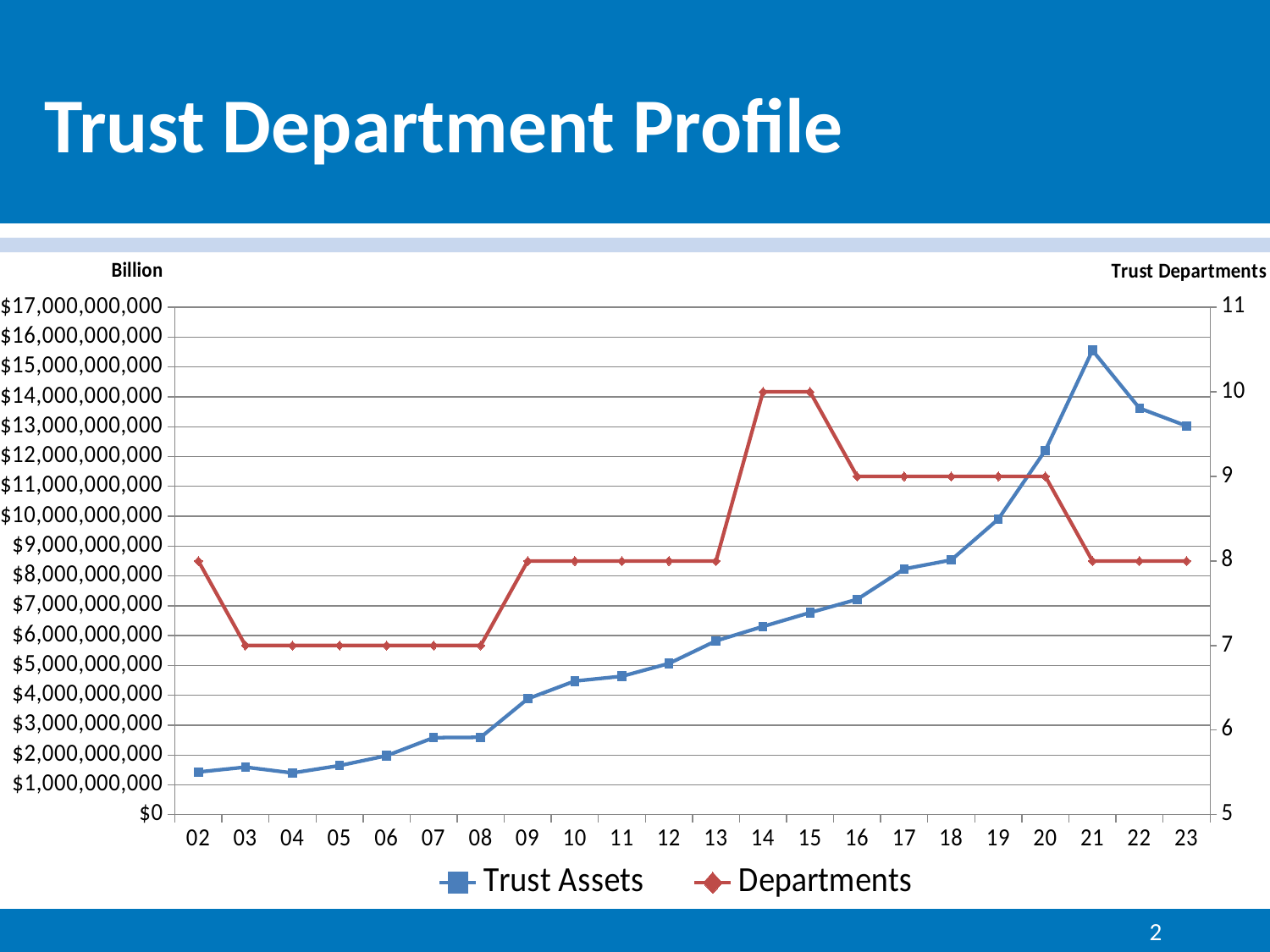
What is the value of the Departments series in 23? 8 How many years are plotted along the x axis? 22 Is the value of Trust Assets in 10 greater or less than $5,000,000,000? less What is the label on the right-hand vertical axis? Trust Departments Is the value of Trust Assets in 21 greater or less than $15,000,000,000? greater What is the value of the Departments series in 14? 10 What is the difference between the Departments value in 14 and the Departments value in 03? 3 How many series does the legend list? 2 What is the value of the Departments series in 05? 7 Which year has the larger Trust Assets value, 22 or 23? 22 What kind of chart is shown on the slide? line chart In which year is Trust Assets highest? 21